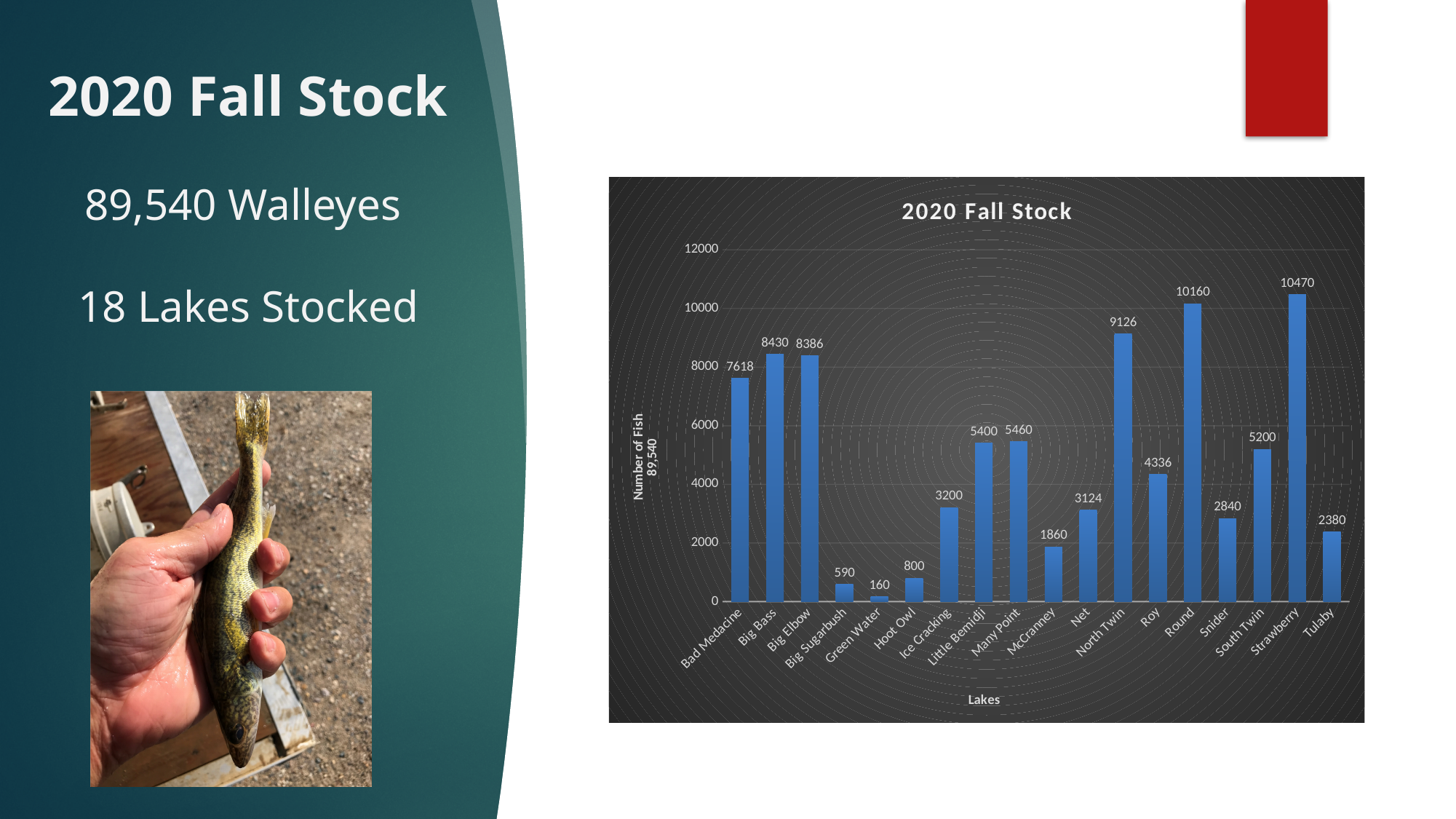
Which lake has the lowest value? Green Water What is the title of the chart? 2020 Fall Stock Is the value for Ice Cracking greater or less than 4000? less Which lake has the highest value? Strawberry What is the value for Strawberry? 10470 What is the value for North Twin? 9126 What is the label of the x axis? Lakes What is the value for Big Sugarbush? 590 How many lakes are shown on the x axis? 18 What is the difference between the values for Round and Roy? 5824 What kind of chart is shown? bar chart Which is larger, the value for Big Bass or the value for Big Elbow? Big Bass